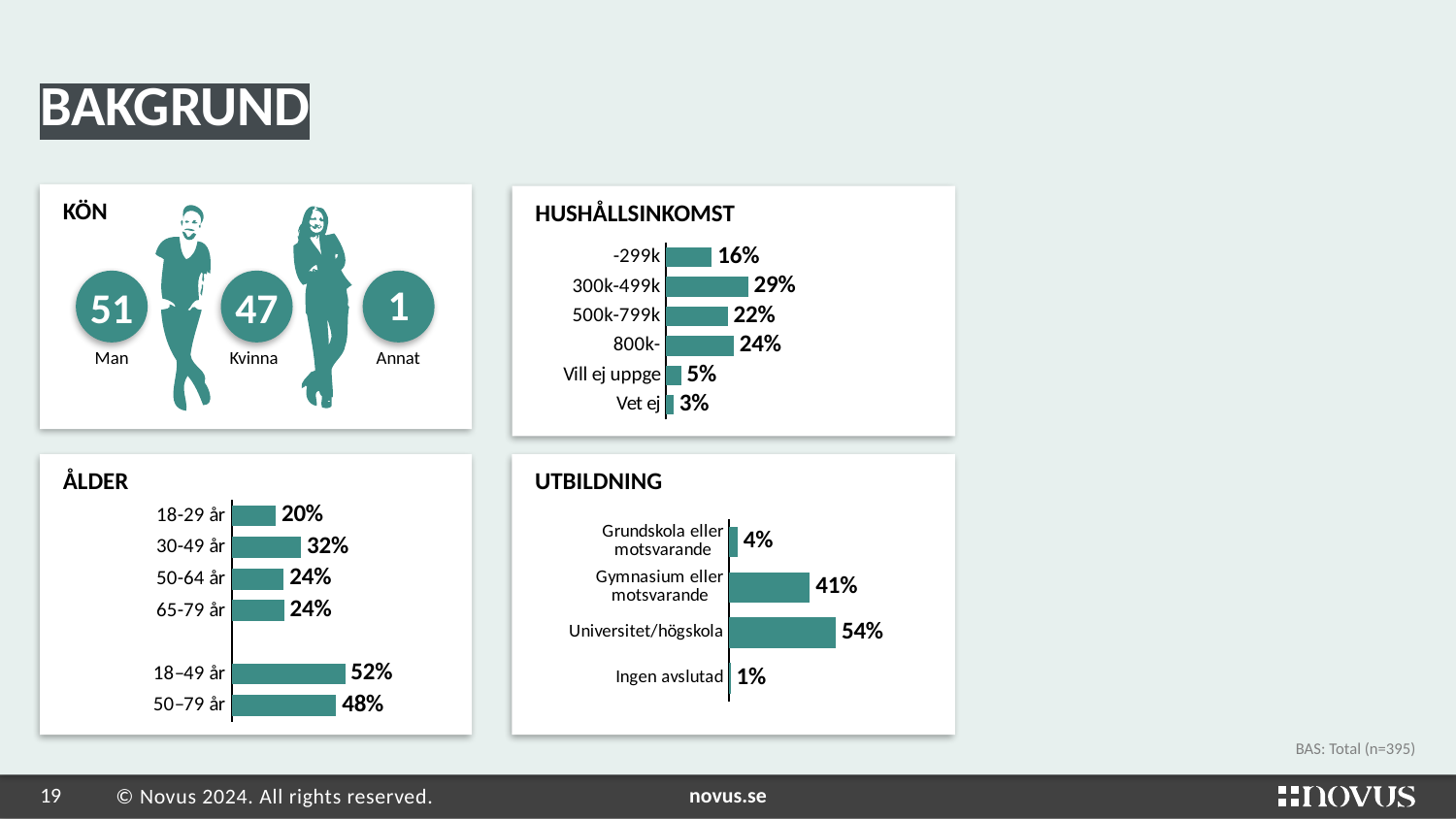
In the ÅLDER chart, what is the value for 30-49 år? 32% In the HUSHÅLLSINKOMST chart, which category has the lowest value? Vet ej In the UTBILDNING chart, what is the value for Ingen avslutad? 1% In the ÅLDER chart, which is larger, 18–49 år or 50–79 år? 18–49 år In the ÅLDER chart, what is the difference between 30-49 år and 18-29 år? 12% In the HUSHÅLLSINKOMST chart, what is the value for 300k-499k? 29% In the UTBILDNING chart, which category has the highest value? Universitet/högskola In the KÖN panel, what is the value shown for Kvinna? 47 In the HUSHÅLLSINKOMST chart, what is the difference between 800k- and 500k-799k? 2% How many categories does the HUSHÅLLSINKOMST chart show? 6 In the UTBILDNING chart, what is the value for Gymnasium eller motsvarande? 41% What type of chart is the UTBILDNING chart? Bar chart